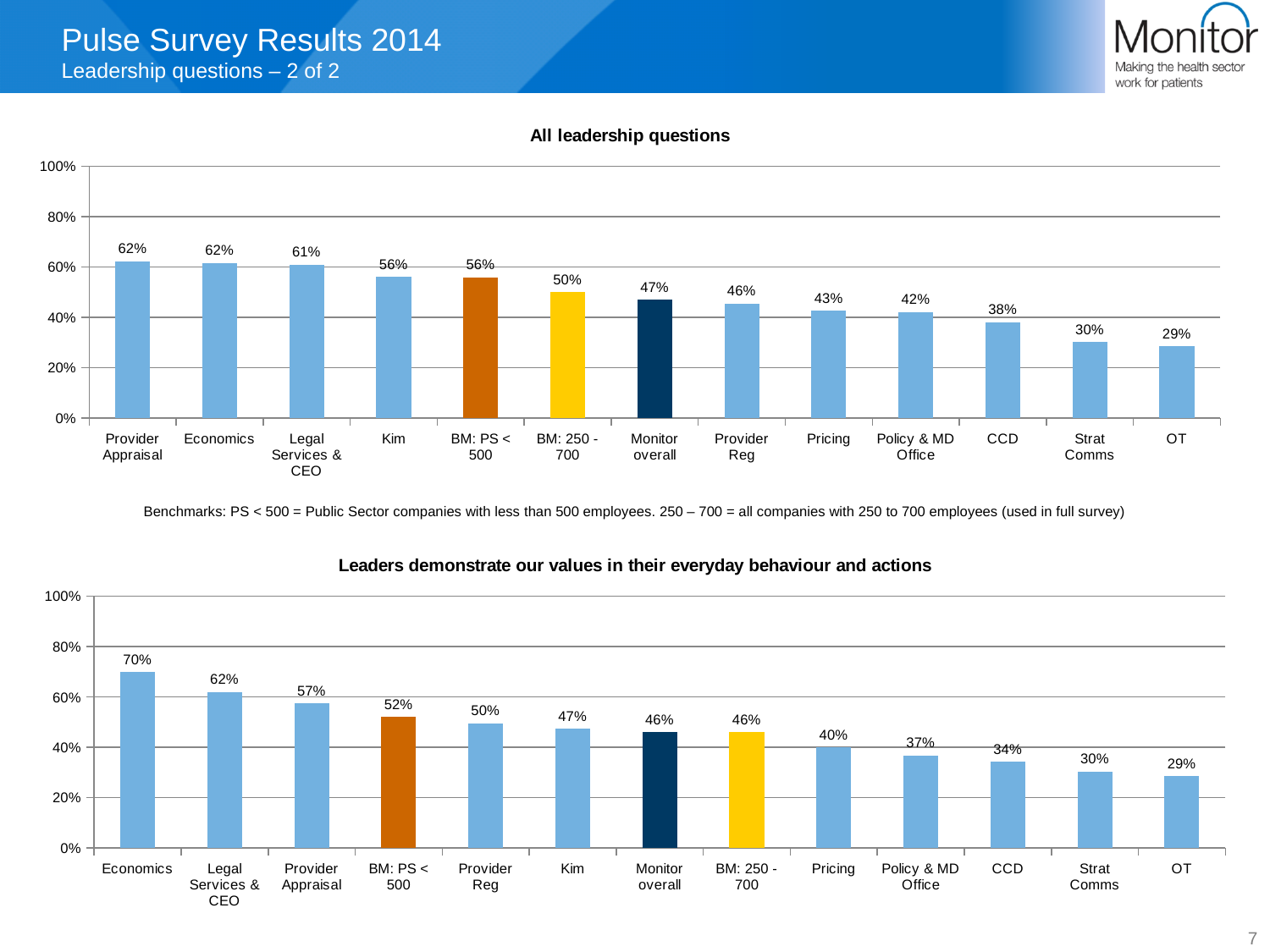
In the 'All leadership questions' chart, what is the value for Monitor overall? 47% In the 'All leadership questions' chart, which is larger, Provider Reg or Policy & MD Office? Provider Reg In the 'Leaders demonstrate our values in their everyday behaviour and actions' chart, what is the value for Provider Reg? 50% In the 'All leadership questions' chart, what is the value for CCD? 38% In the 'Leaders demonstrate our values in their everyday behaviour and actions' chart, which category has the highest value? Economics In the 'Leaders demonstrate our values in their everyday behaviour and actions' chart, do the values rise or fall from left to right? Fall How many categories are shown in the 'All leadership questions' chart? 13 In the 'Leaders demonstrate our values in their everyday behaviour and actions' chart, what is the difference between Economics and OT? 41% In the 'Leaders demonstrate our values in their everyday behaviour and actions' chart, what is the value for BM: 250 - 700? 46% In the 'All leadership questions' chart, what is the value for Kim? 56% What type of chart is the 'Leaders demonstrate our values in their everyday behaviour and actions' chart? Bar chart In the 'All leadership questions' chart, what is the difference between Legal Services & CEO and Pricing? 18%